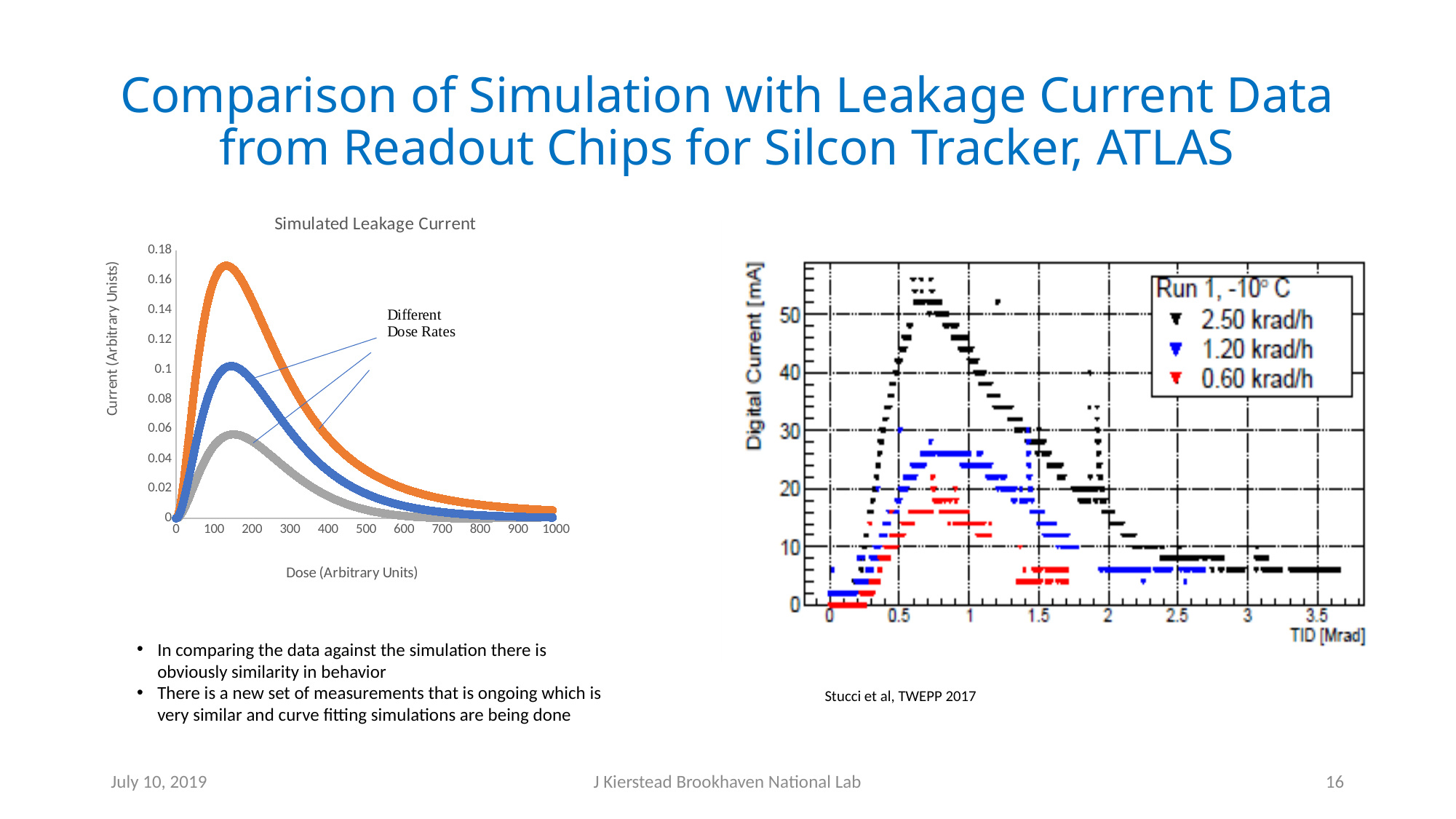
In the 'Simulated Leakage Current' chart, do the values of the orange curve rise or fall between dose 200 and dose 1000? fall In the chart on the right (Run 1, -10° C), is the peak digital current of the 2.50 krad/h series greater or less than 50? greater In the 'Simulated Leakage Current' chart, what is the label of the x axis? Dose (Arbitrary Units) In the 'Simulated Leakage Current' chart, is the peak value of the gray curve greater or less than 0.08? less What kind of chart is the 'Simulated Leakage Current' chart on the left? line chart In the 'Simulated Leakage Current' chart, is the peak value of the orange curve greater or less than 0.14? greater In the chart on the right (Run 1, -10° C), how many series does the legend list? 3 In the 'Simulated Leakage Current' chart, how many curves are plotted? 3 In the chart on the right (Run 1, -10° C), which dose rate series reaches the highest digital current? 2.50 krad/h What is the title of the chart on the left of the slide? Simulated Leakage Current In the 'Simulated Leakage Current' chart, which curve reaches the highest current: orange, blue or gray? orange